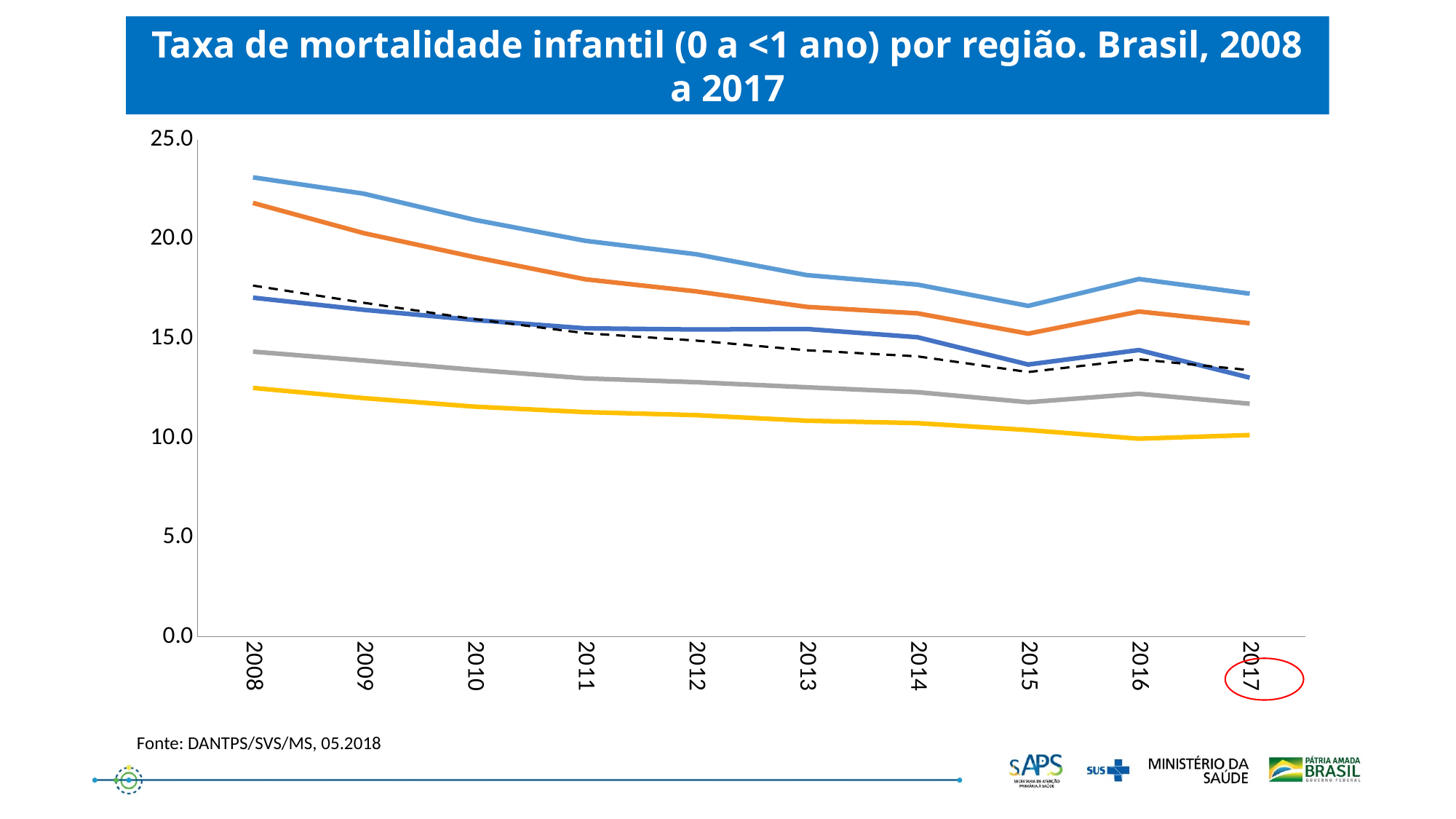
Is the value of the grey line in 2008 greater or less than 15.0? less How many years are shown along the x axis of the chart? 10 Do the values of the lines generally rise or fall from 2008 to 2017? fall What is the title of the chart? Taxa de mortalidade infantil (0 a <1 ano) por região. Brasil, 2008 a 2017 What source is cited below the chart? Fonte: DANTPS/SVS/MS, 05.2018 Is the value of the yellow line in 2017 greater or less than 15.0? less In which year does the light blue line reach its highest value? 2008 In 2008, is the orange line higher or lower than the yellow line? higher How many lines are plotted on the chart? 6 Is the value of the orange line in 2017 greater or less than 15.0? greater What kind of chart is shown on the slide? line chart